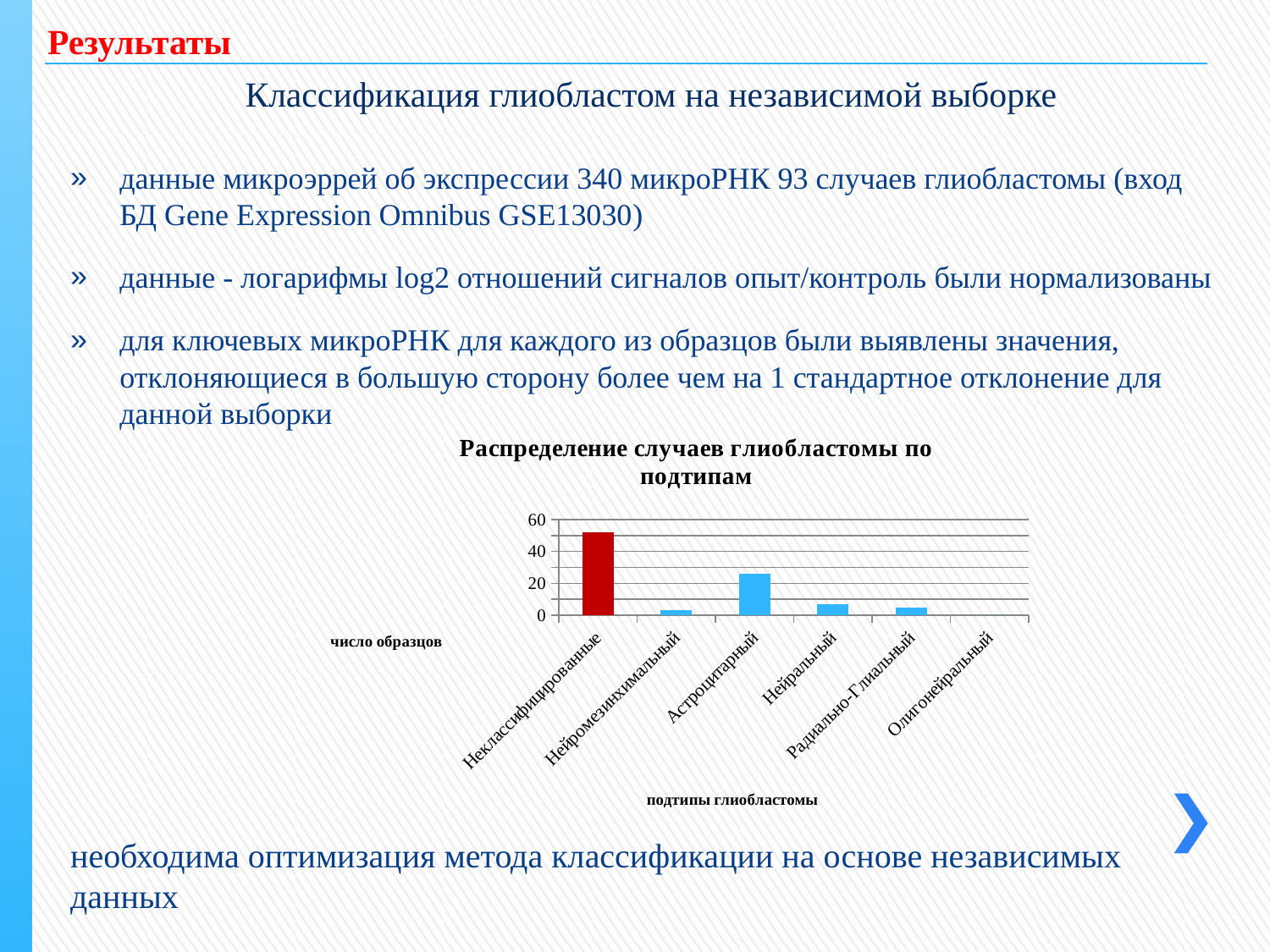
Which has more samples, Астроцитарный or Нейральный? Астроцитарный Which has more samples, Неклассифицированные or Астроцитарный? Неклассифицированные Which has more samples, Нейральный or Нейромезинхимальный? Нейральный What kind of chart is shown on the slide? bar chart Which subtype has the highest number of samples in the chart? Неклассифицированные How many glioblastoma subtypes (categories) are shown on the x axis of the chart? 6 What is the title of the chart? Распределение случаев глиобластомы по подтипам Is the value for Нейральный greater or less than 20? less Is the value for Астроцитарный greater or less than 20? greater What colour is the bar for Неклассифицированные in the chart? red Is the value for Неклассифицированные greater or less than 40? greater